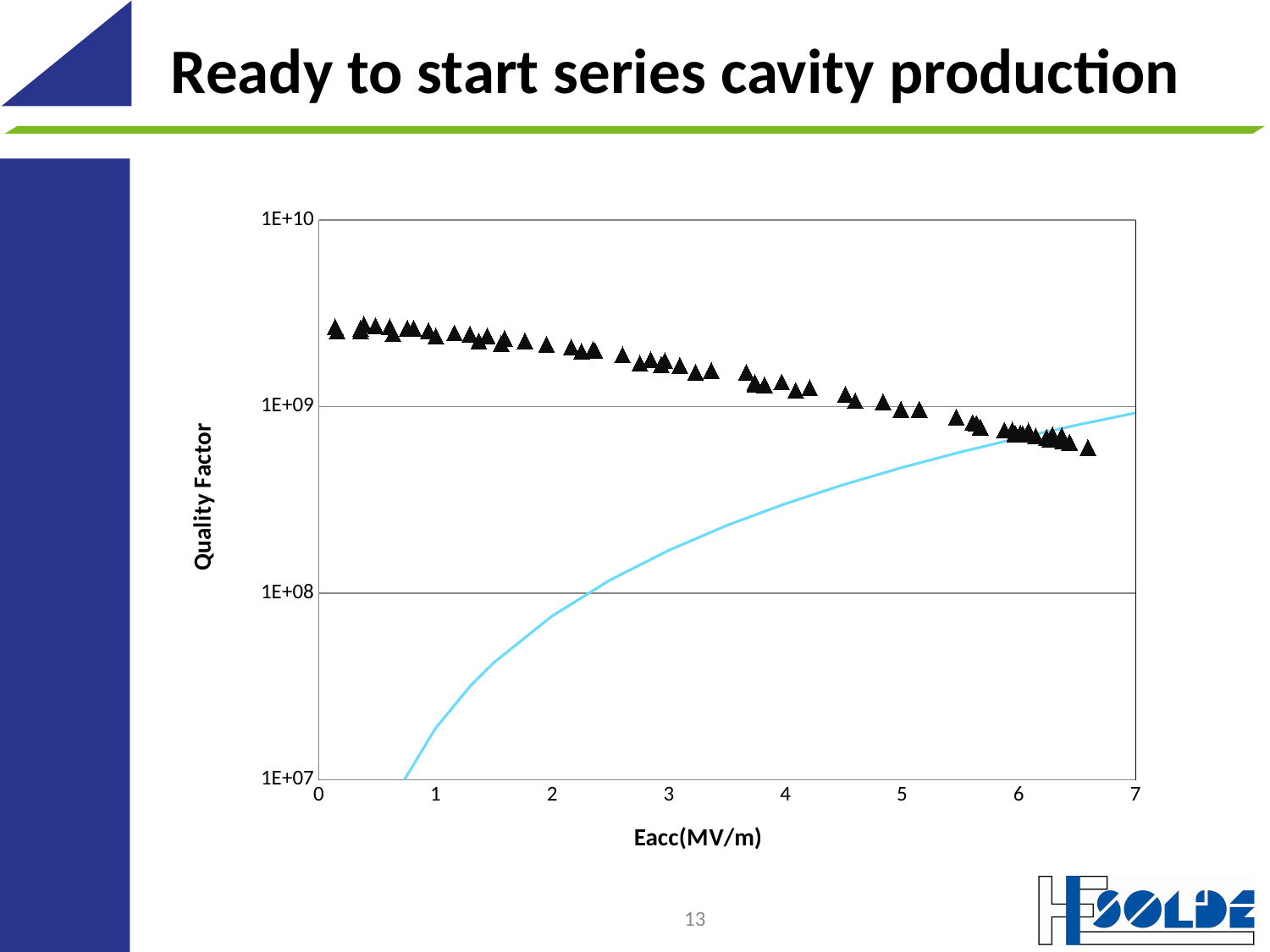
What is the label of the x axis? Eacc(MV/m) At Eacc = 3 MV/m, which is higher: the triangle data points or the blue curve? the triangle data points Do the triangle data points rise or fall as Eacc increases? fall What kind of chart is shown on the slide? scatter chart Does the blue curve rise or fall as Eacc increases? rise What is the label of the y axis? Quality Factor Is the value of the blue curve at Eacc = 4 MV/m greater or less than 1E+08? greater Is the value of the blue curve at Eacc = 6 MV/m greater or less than 1E+09? less Is the Quality Factor of the triangle data points at Eacc = 1 MV/m greater or less than 1E+09? greater What is the highest value shown on the y axis? 1E+10